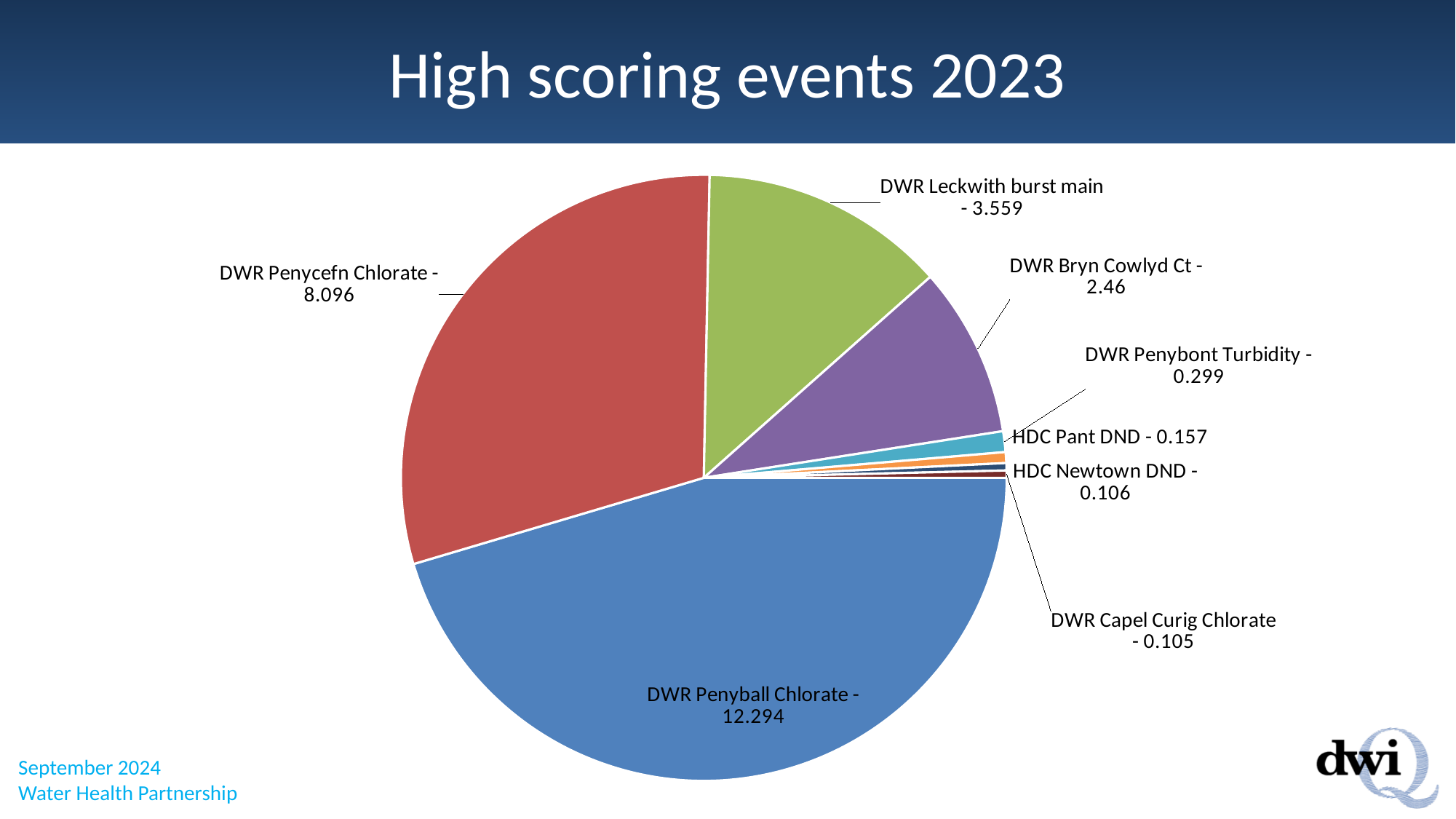
Which event has the highest value? DWR Penyball Chlorate What is the value for DWR Leckwith burst main? 3.559 What is the title of the chart? High scoring events 2023 What kind of chart is shown on the slide? Pie chart What is the difference between the values for DWR Penyball Chlorate and DWR Penycefn Chlorate? 4.198 What is the value for DWR Penybont Turbidity? 0.299 What is the difference between the values for DWR Leckwith burst main and DWR Bryn Cowlyd Ct? 1.099 What is the value for DWR Penyball Chlorate? 12.294 Which event has the lowest value? DWR Capel Curig Chlorate Which is larger, the value for DWR Bryn Cowlyd Ct or the value for DWR Penybont Turbidity? DWR Bryn Cowlyd Ct How many events (slices) are shown in the pie chart? 8 What is the value for HDC Pant DND? 0.157